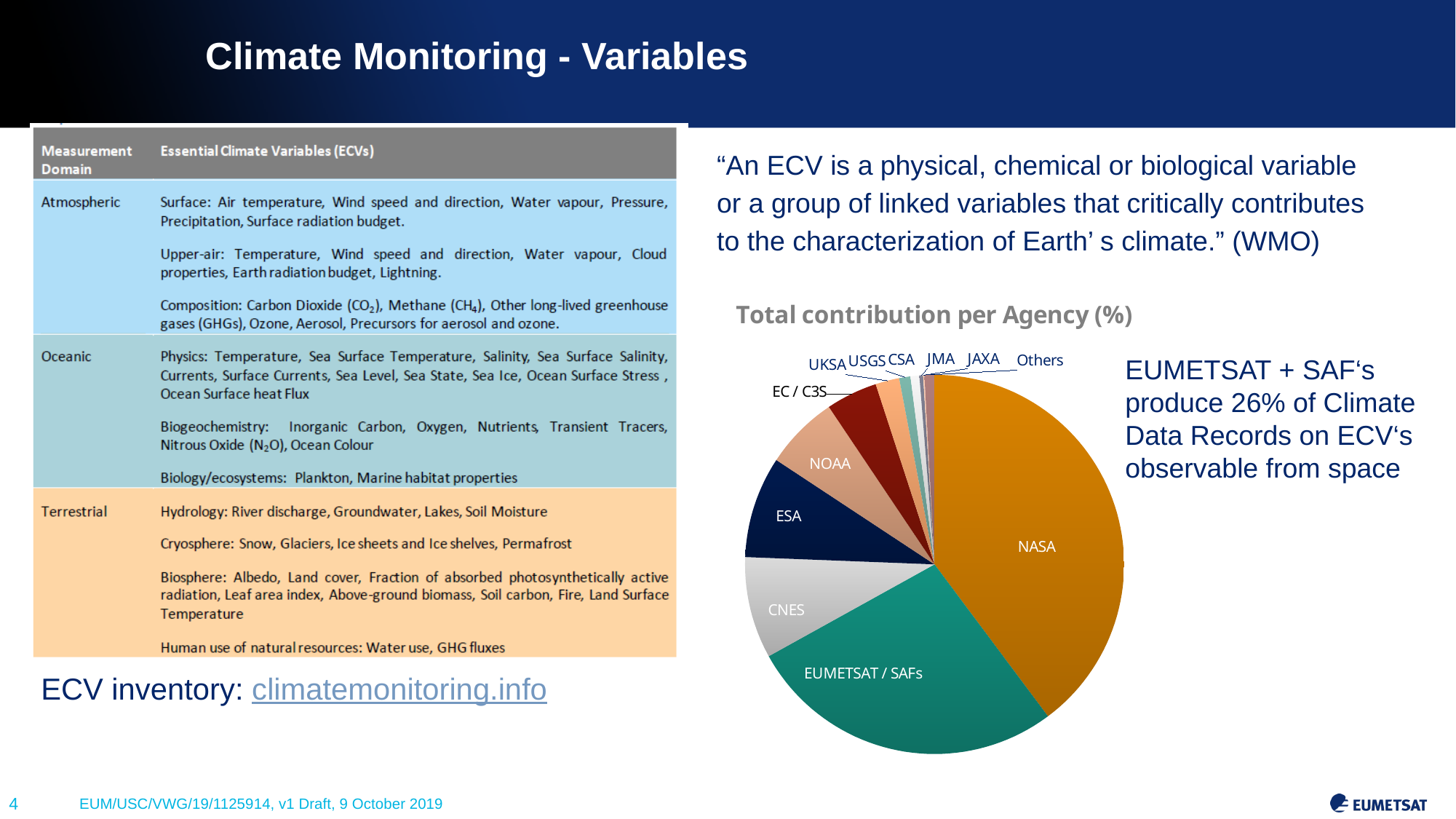
In the pie chart "Total contribution per Agency (%)", what colour is the NASA slice? orange What is the title of the pie chart on the slide? Total contribution per Agency (%) According to the slide, what share of Climate Data Records on ECVs observable from space do EUMETSAT + SAFs produce? 26% In the pie chart "Total contribution per Agency (%)", which agency has the largest slice? NASA What kind of chart is shown under the title "Total contribution per Agency (%)"? pie chart In the pie chart "Total contribution per Agency (%)", which slice is larger: ESA or NOAA? ESA In the pie chart "Total contribution per Agency (%)", which slice is larger: EUMETSAT / SAFs or ESA? EUMETSAT / SAFs How many slices (agencies) does the pie chart "Total contribution per Agency (%)" have? 12 In the pie chart "Total contribution per Agency (%)", which slice is larger: NOAA or EC / C3S? NOAA